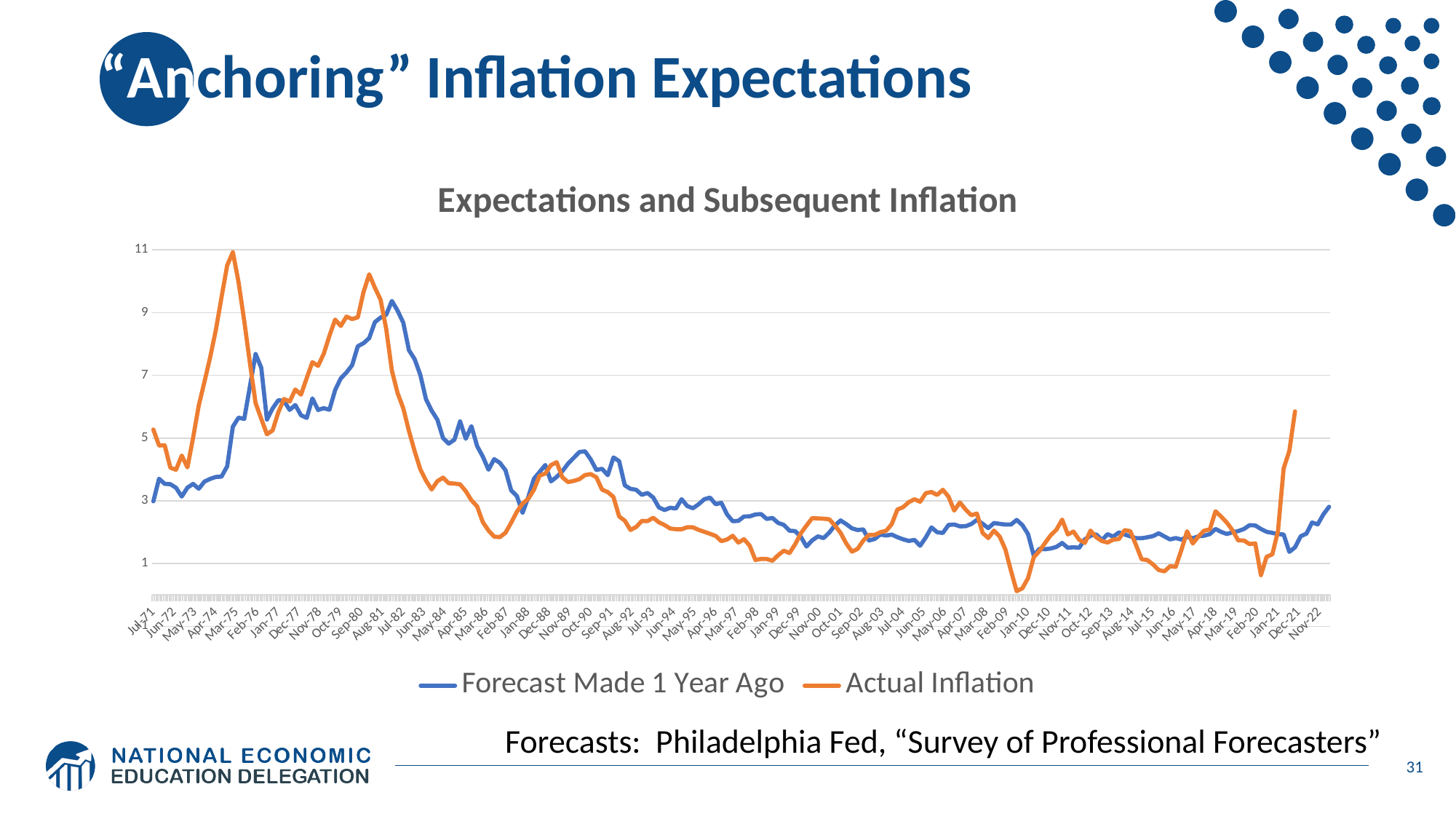
Is the value of Actual Inflation at Dec-21 greater or less than 5? greater What kind of chart is shown on the slide? Line chart How many series does the legend list? 2 Which series is drawn in orange? Actual Inflation Around Mar-75, which series is higher, Forecast Made 1 Year Ago or Actual Inflation? Actual Inflation Is the value of Actual Inflation around Jan-10 greater or less than 1? less Does Actual Inflation rise or fall between Feb-20 and Dec-21? Rise What is the title of the chart? Expectations and Subsequent Inflation Which series reaches the highest value anywhere on the chart? Actual Inflation Is the peak value of Actual Inflation around Mar-75 greater or less than 9? greater Around Jan-10, which series is higher, Forecast Made 1 Year Ago or Actual Inflation? Forecast Made 1 Year Ago